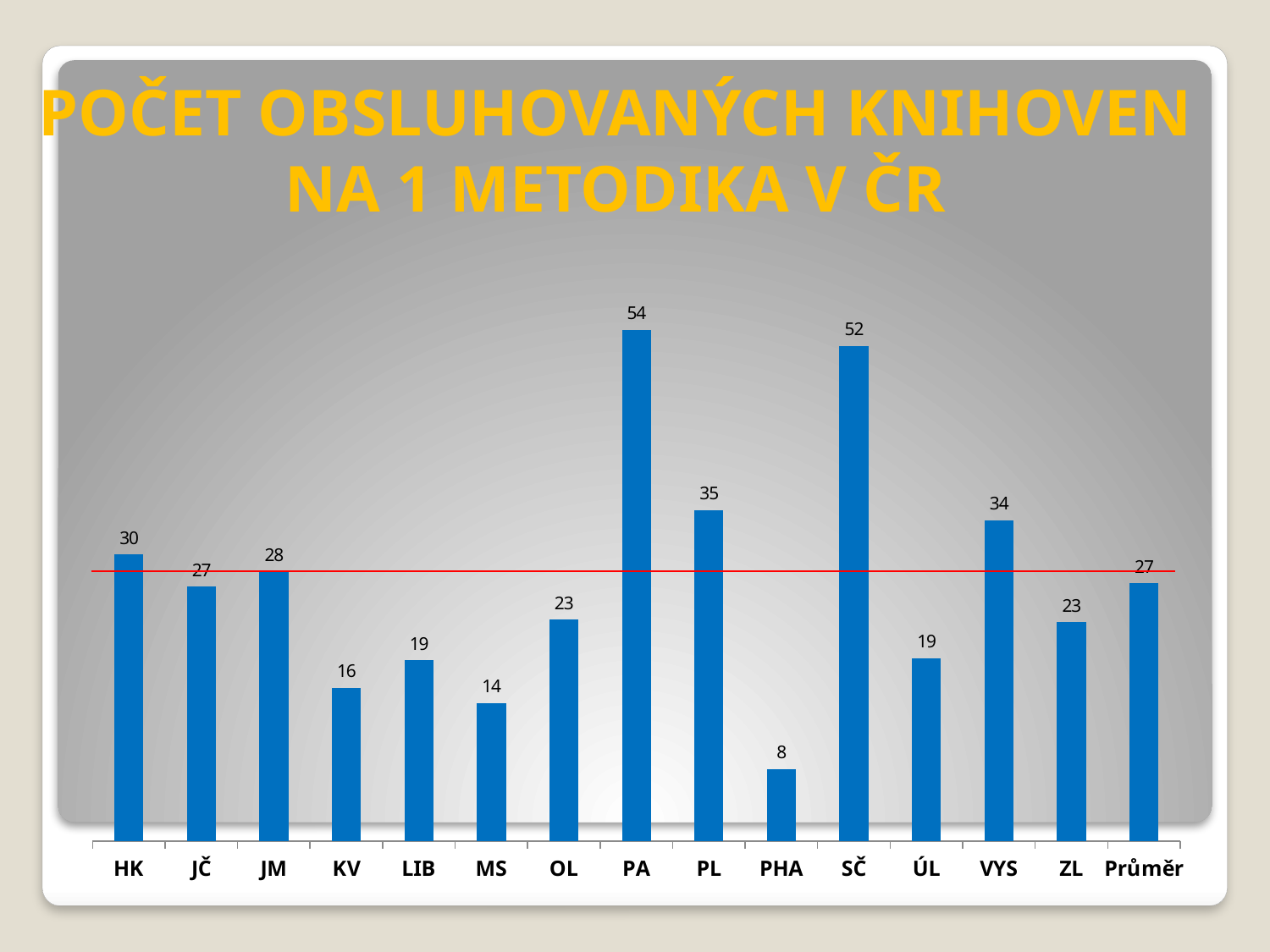
How many categories are shown on the x axis? 15 What is the value for Průměr? 27 What kind of chart is shown on the slide? bar chart Which is larger, the value for HK or the value for JČ? HK Which category has the lowest value? PHA What is the value for PHA? 8 What is the value for VYS? 34 What is the value for PA? 54 What is the difference between the values for PA and SČ? 2 What is the title of the chart? POČET OBSLUHOVANÝCH KNIHOVEN NA 1 METODIKA V ČR Which category has the highest value? PA What is the difference between the values for PL and PHA? 27